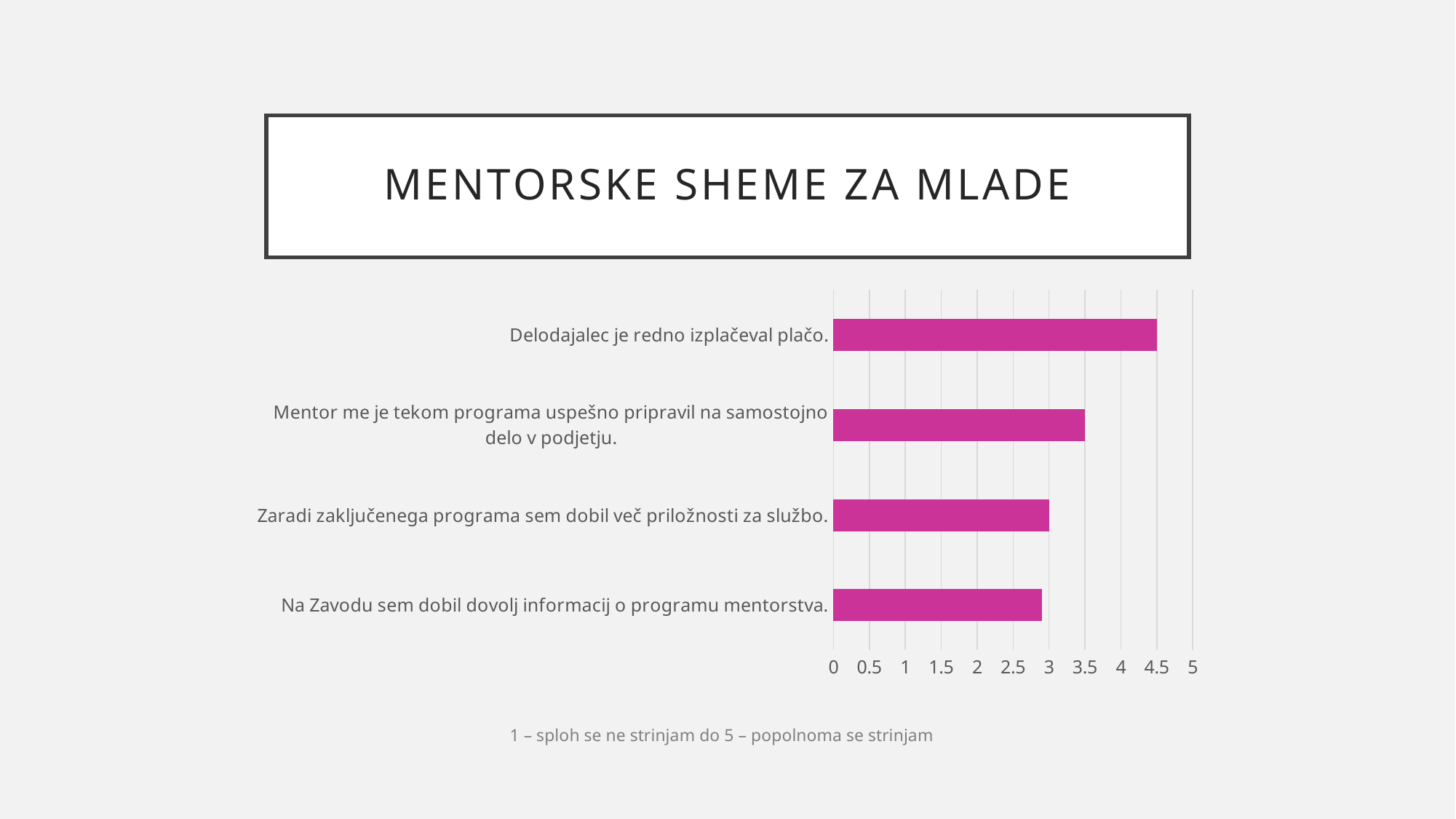
What kind of chart is shown on the slide? bar chart What is the value for "Delodajalec je redno izplačeval plačo."? 4.5 Which statement has the lowest value? Na Zavodu sem dobil dovolj informacij o programu mentorstva. Which statement has the highest value? Delodajalec je redno izplačeval plačo. Is the value for "Na Zavodu sem dobil dovolj informacij o programu mentorstva." greater or less than 2.5? greater Which has a larger value: "Mentor me je tekom programa uspešno pripravil na samostojno delo v podjetju." or "Zaradi zaključenega programa sem dobil več priložnosti za službo."? Mentor me je tekom programa uspešno pripravil na samostojno delo v podjetju. How many categories (statements) are plotted in the chart? 4 What is the value for "Zaradi zaključenega programa sem dobil več priložnosti za službo."? 3 What is the title shown above the chart? MENTORSKE SHEME ZA MLADE Is the value for "Na Zavodu sem dobil dovolj informacij o programu mentorstva." greater or less than 3? less What is the value for "Mentor me je tekom programa uspešno pripravil na samostojno delo v podjetju."? 3.5 What is the difference between the values for "Delodajalec je redno izplačeval plačo." and "Mentor me je tekom programa uspešno pripravil na samostojno delo v podjetju."? 1